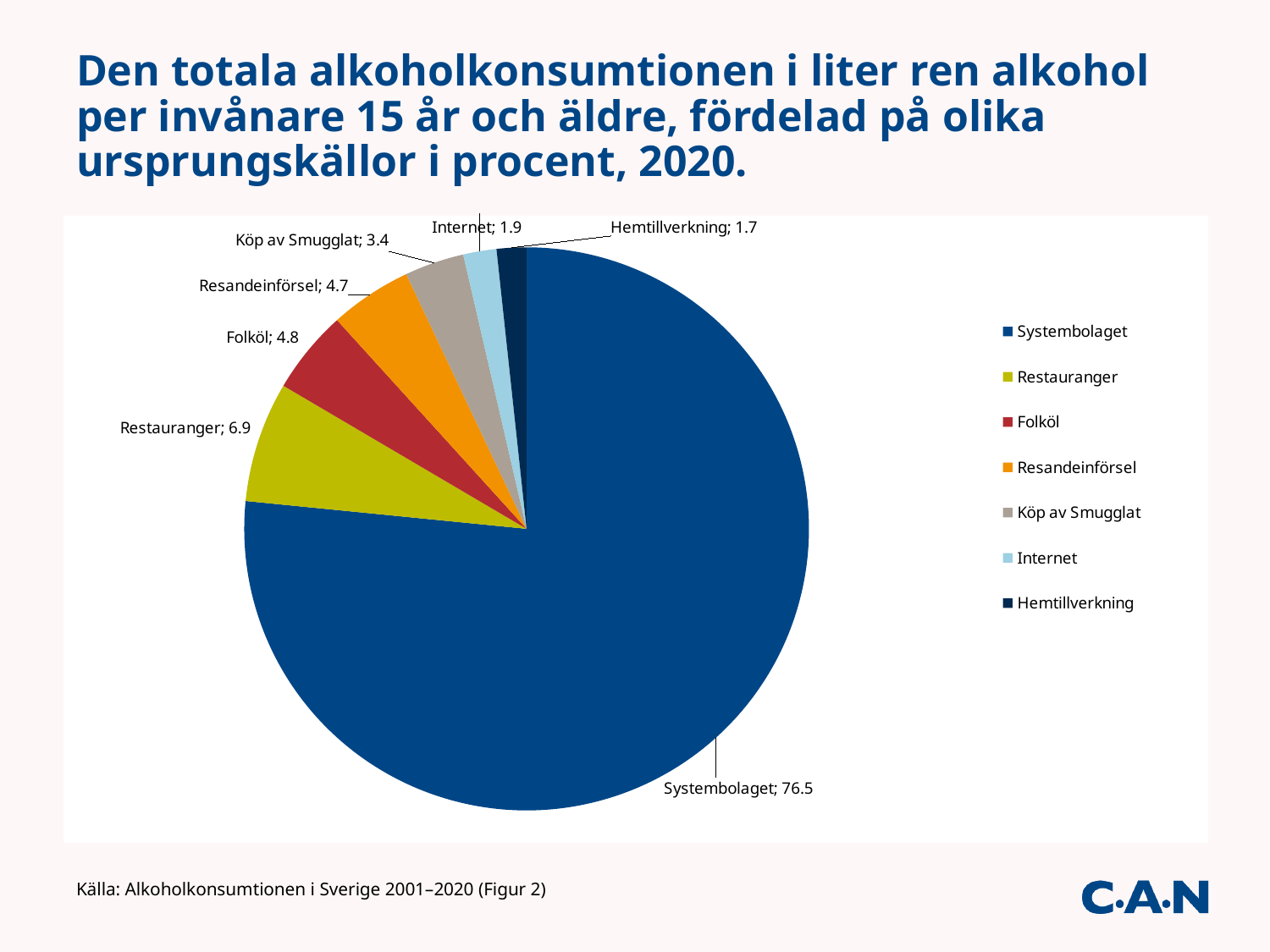
What is the value shown for Systembolaget in the pie chart? 76.5 Which category has the smallest slice of the pie chart? Hemtillverkning What is the difference between the values for Restauranger and Folköl? 2.1 Which is larger, the value for Internet or the value for Hemtillverkning? Internet What is the value shown for Köp av Smugglat in the pie chart? 3.4 What is the difference between the values for Systembolaget and Restauranger? 69.6 What is the value shown for Hemtillverkning in the pie chart? 1.7 What is the value shown for Restauranger in the pie chart? 6.9 What share of the pie does Folköl account for? 4.8 How many categories are shown in the pie chart? 7 Which category has the largest slice of the pie chart? Systembolaget What kind of chart is shown on the slide? Pie chart